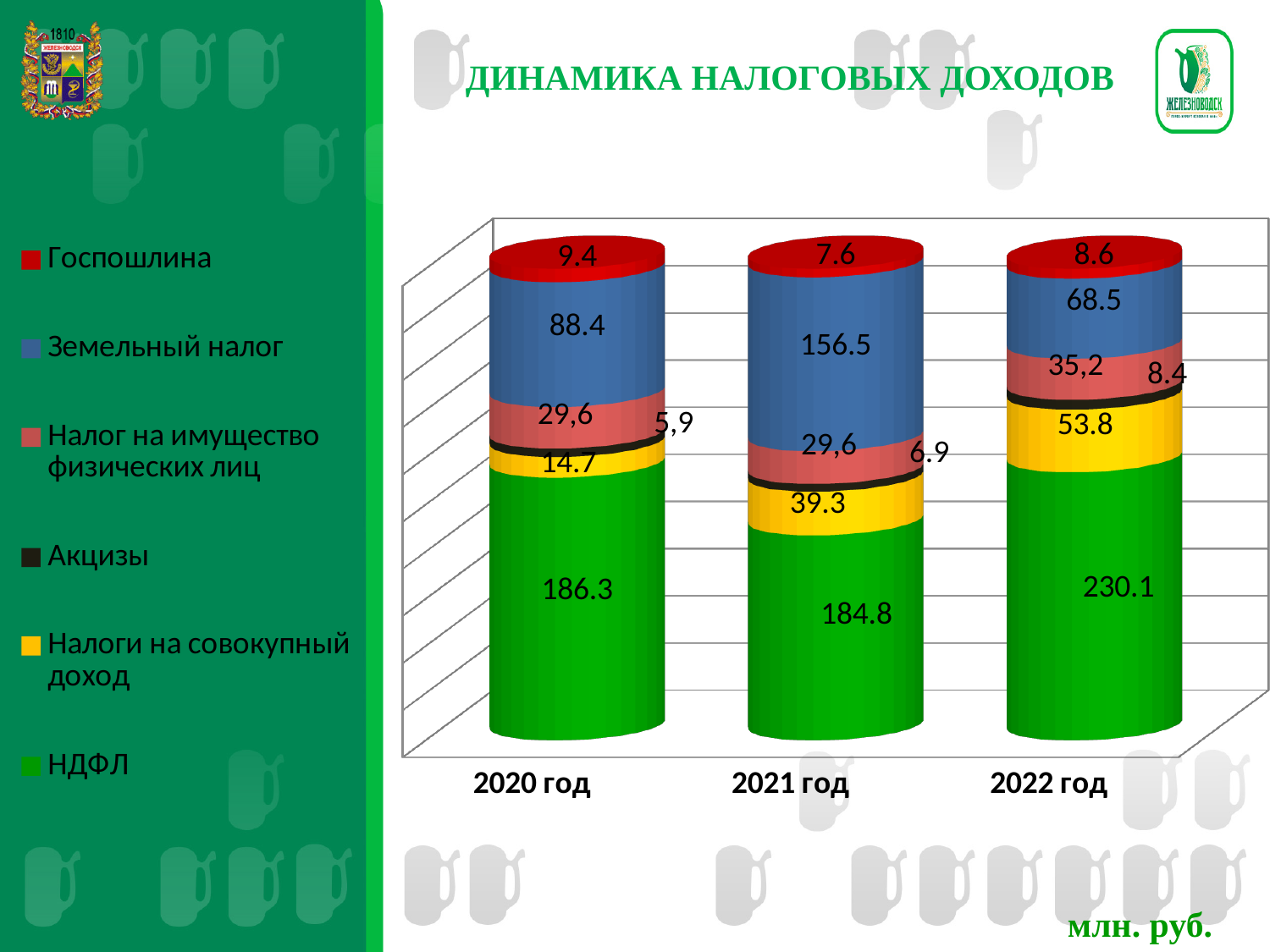
What is the value of Акцизы for 2022 год? 8.4 In which year is the value of Налоги на совокупный доход lowest? 2020 год In which year is the value of Земельный налог highest? 2021 год How many years are shown on the x axis? 3 What is the total of the stacked bar for 2020 год? 334.3 What is the value of НДФЛ for 2022 год? 230.1 What is the value of Налоги на совокупный доход for 2020 год? 14.7 What is the value of Госпошлина for 2021 год? 7.6 Which is larger: Земельный налог in 2020 год or Земельный налог in 2022 год? Земельный налог in 2020 год How many series does the legend list? 6 What is the difference between the НДФЛ values for 2022 год and 2021 год? 45.3 What is the value of Земельный налог for 2021 год? 156.5